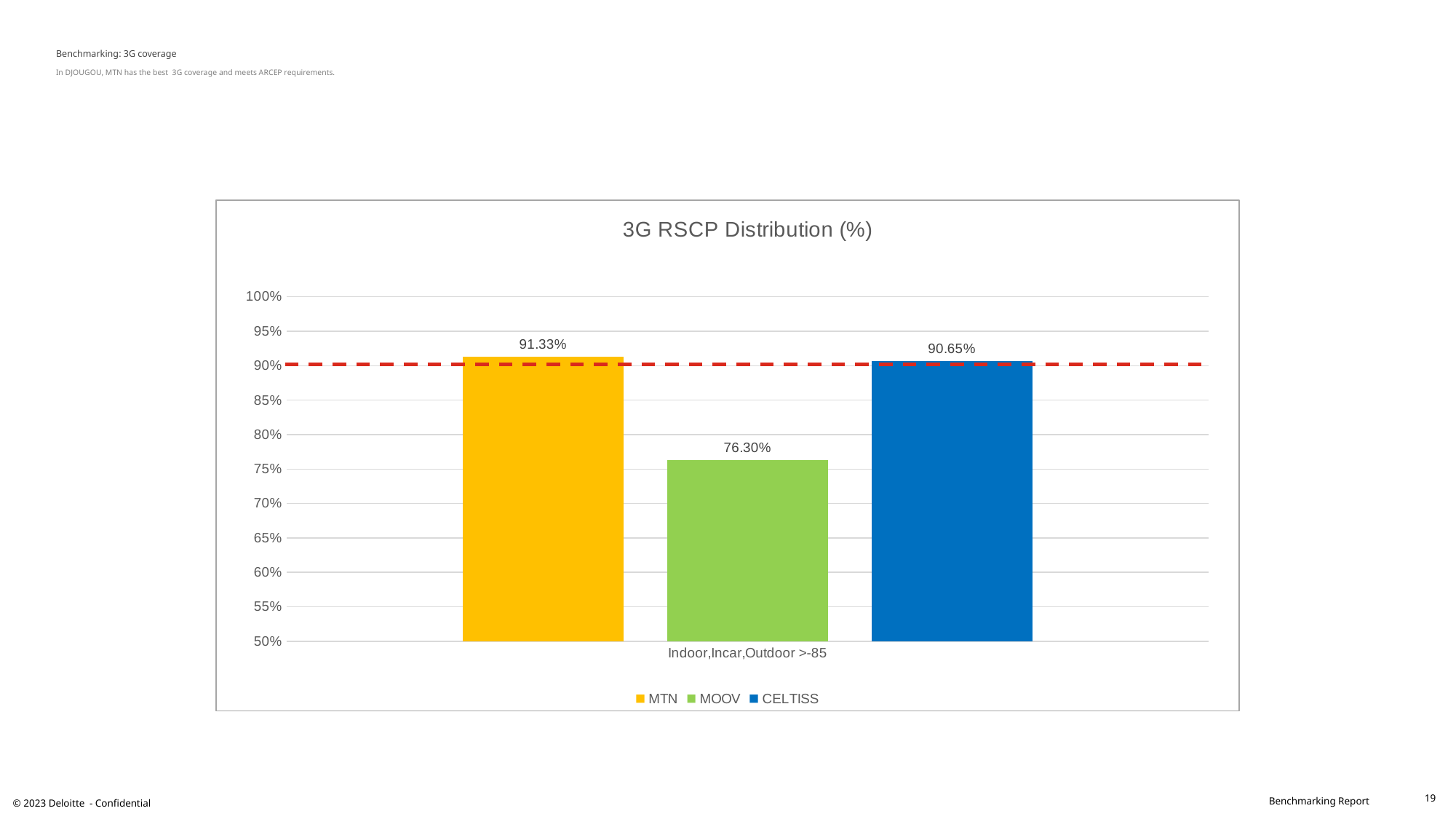
Which operator has the highest value in the 3G RSCP Distribution (%) chart? MTN What is the value for MTN in the 3G RSCP Distribution (%) chart? 91.33% What is the x-axis category label in the 3G RSCP Distribution (%) chart? Indoor,Incar,Outdoor >-85 What is the difference between the MTN and CELTISS values in the 3G RSCP Distribution (%) chart? 0.68% What is the difference between the MTN and MOOV values in the 3G RSCP Distribution (%) chart? 15.03% What is the value for CELTISS in the 3G RSCP Distribution (%) chart? 90.65% How many series does the legend of the 3G RSCP Distribution (%) chart list? 3 What kind of chart is the 3G RSCP Distribution (%) chart? bar chart What is the value for MOOV in the 3G RSCP Distribution (%) chart? 76.30% Is the value for MOOV in the 3G RSCP Distribution (%) chart greater or less than 80%? less Which is larger in the 3G RSCP Distribution (%) chart, the value for MOOV or the value for CELTISS? CELTISS Which operator has the lowest value in the 3G RSCP Distribution (%) chart? MOOV